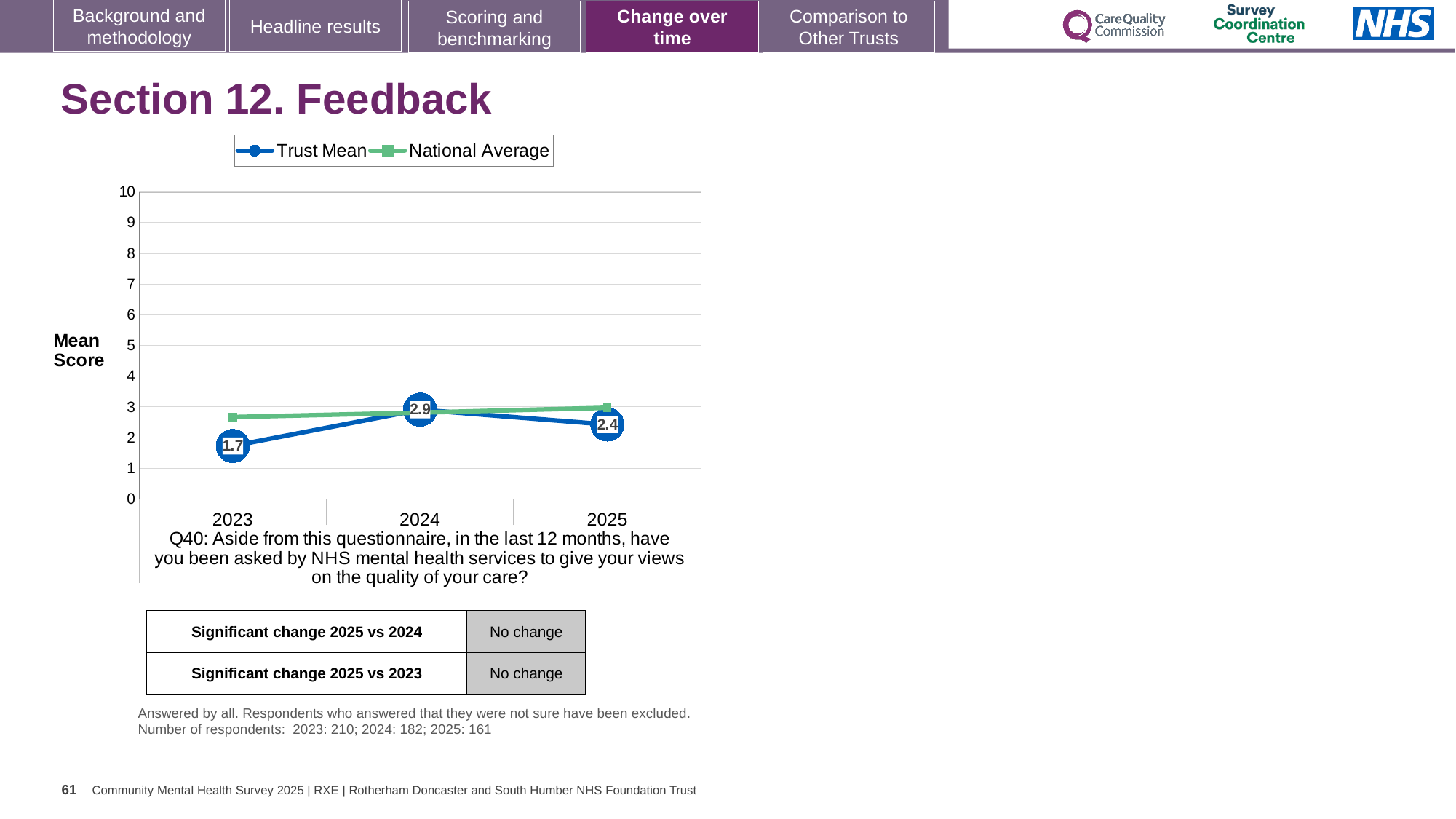
What is the Trust Mean value for 2024? 2.9 Is the National Average value for 2023 greater or less than 3? less What is the difference between the Trust Mean in 2024 and in 2023? 1.2 What is the Trust Mean value for 2023? 1.7 In which year is the Trust Mean highest? 2024 What is the difference between the Trust Mean in 2024 and in 2025? 0.5 Which is larger, the Trust Mean in 2025 or the Trust Mean in 2023? 2025 How many years are plotted on the x axis? 3 In which year is the Trust Mean lowest? 2023 What is the Trust Mean value for 2025? 2.4 What kind of chart is shown on the slide? line chart How many series does the legend list? 2